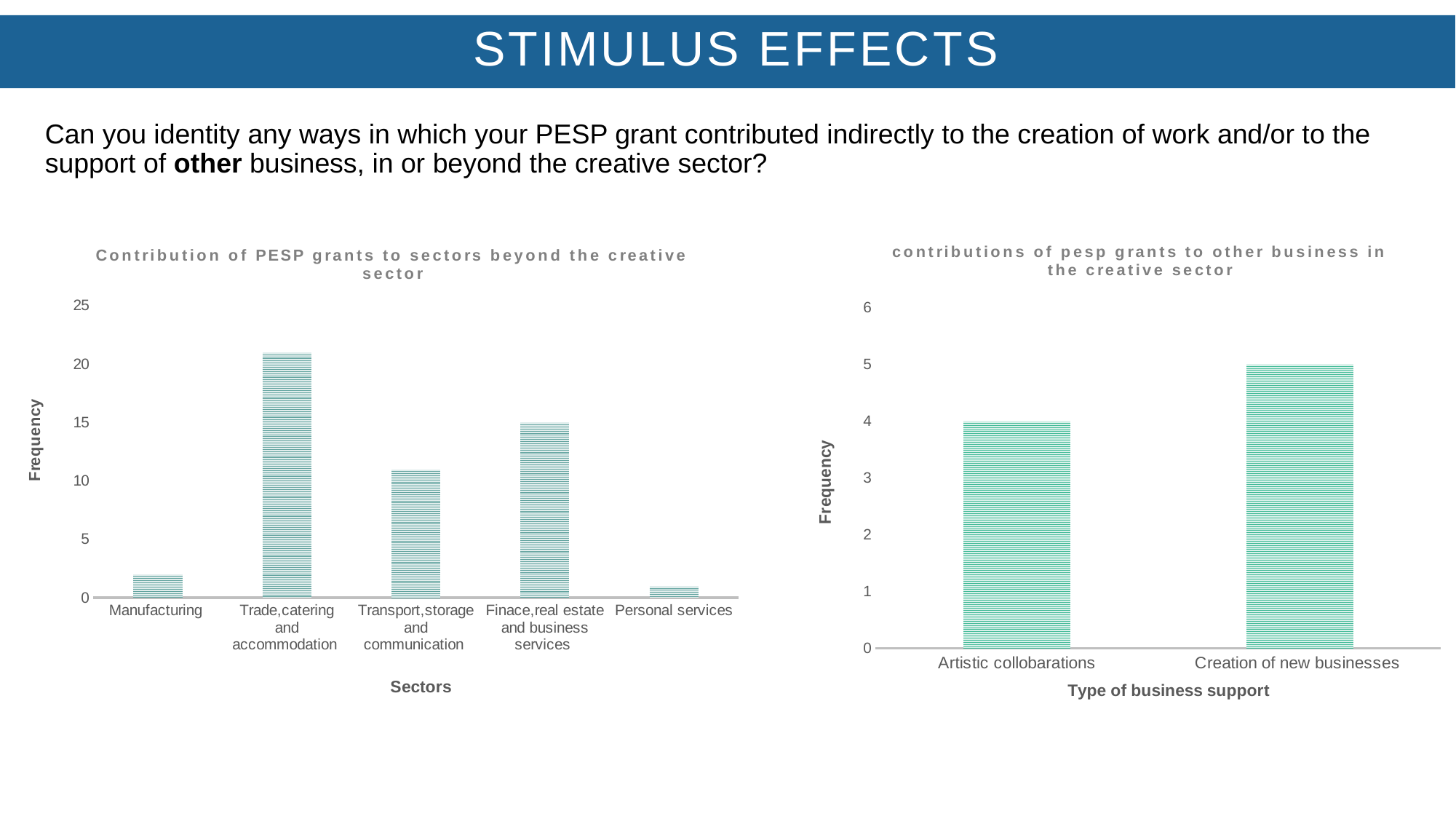
In the chart titled 'contributions of pesp grants to other business in the creative sector', what is the difference between Creation of new businesses and Artistic collobarations? 1 In the chart titled 'contributions of pesp grants to other business in the creative sector', what is the frequency for Artistic collobarations? 4 In the chart titled 'Contribution of PESP grants to sectors beyond the creative sector', which is larger: Finace,real estate and business services or Transport,storage and communication? Finace,real estate and business services In the chart titled 'Contribution of PESP grants to sectors beyond the creative sector', is the value for Transport,storage and communication greater or less than 15? less How many sectors are shown in the chart titled 'Contribution of PESP grants to sectors beyond the creative sector'? 5 In the chart titled 'Contribution of PESP grants to sectors beyond the creative sector', which sector has the lowest frequency? Personal services What is the x-axis title of the chart on the right of the slide? Type of business support What type of chart is the chart titled 'Contribution of PESP grants to sectors beyond the creative sector'? bar chart In the chart titled 'Contribution of PESP grants to sectors beyond the creative sector', is the value for Manufacturing greater or less than 5? less In the chart titled 'Contribution of PESP grants to sectors beyond the creative sector', which sector has the highest frequency? Trade,catering and accommodation In the chart titled 'contributions of pesp grants to other business in the creative sector', what is the frequency for Creation of new businesses? 5 In the chart titled 'Contribution of PESP grants to sectors beyond the creative sector', is the value for Trade,catering and accommodation greater or less than 20? greater